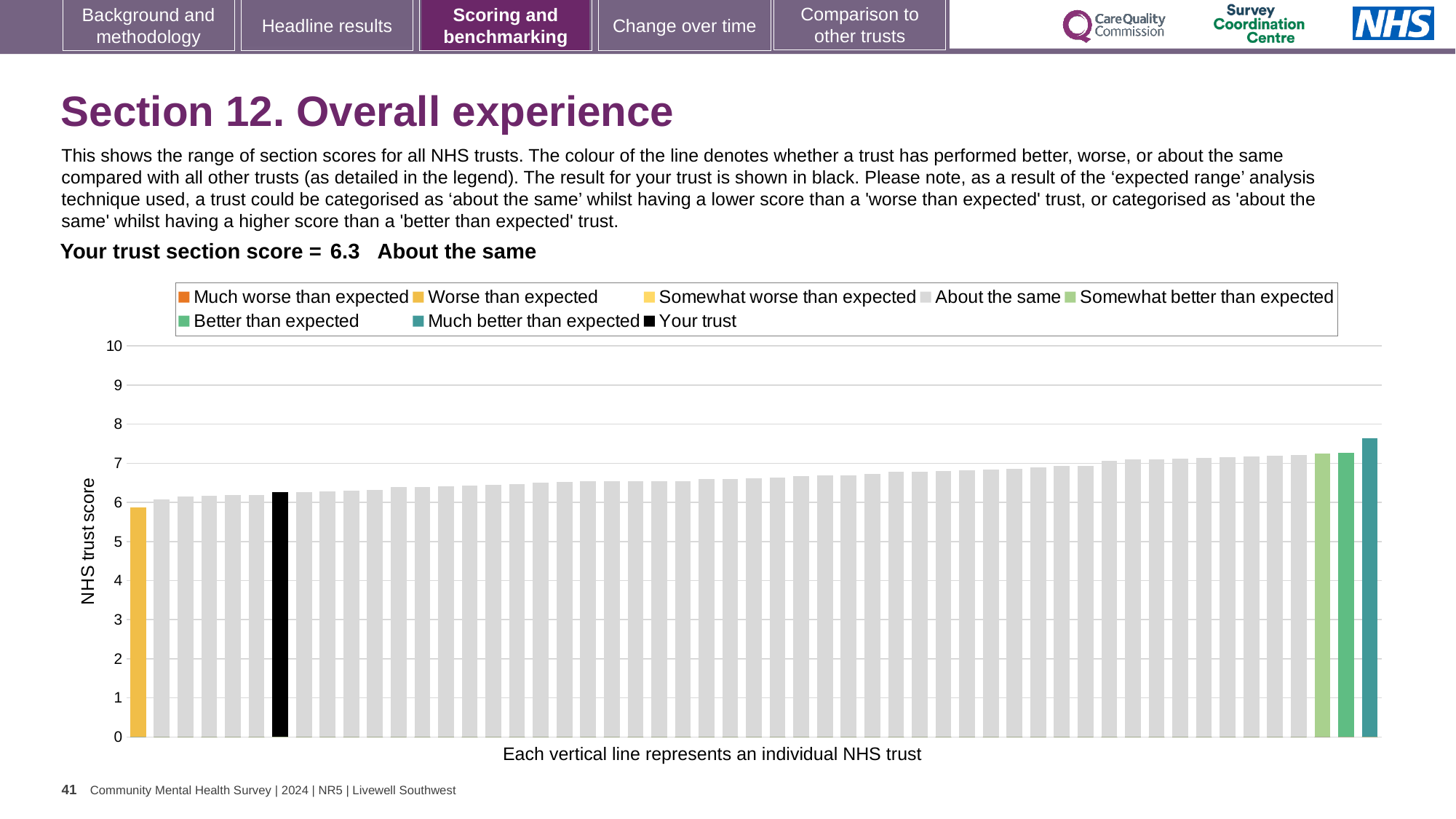
Do the bar values rise or fall moving from left to right along the x axis? rise Is the value of the tallest bar greater or less than 8? less How many entries does the chart legend list? 8 Which benchmarking category is your trust placed in for Section 12? About the same Which legend category does the tallest bar belong to? Much better than expected What is the section score for your trust shown on the slide? 6.3 Is the value for your trust (the black bar) greater or less than 6? greater What kind of chart is shown on the slide? bar chart Is the value of the leftmost (yellow) bar greater or less than 7? less Which legend category does the shortest bar belong to? Worse than expected What is the label on the vertical axis of the chart? NHS trust score